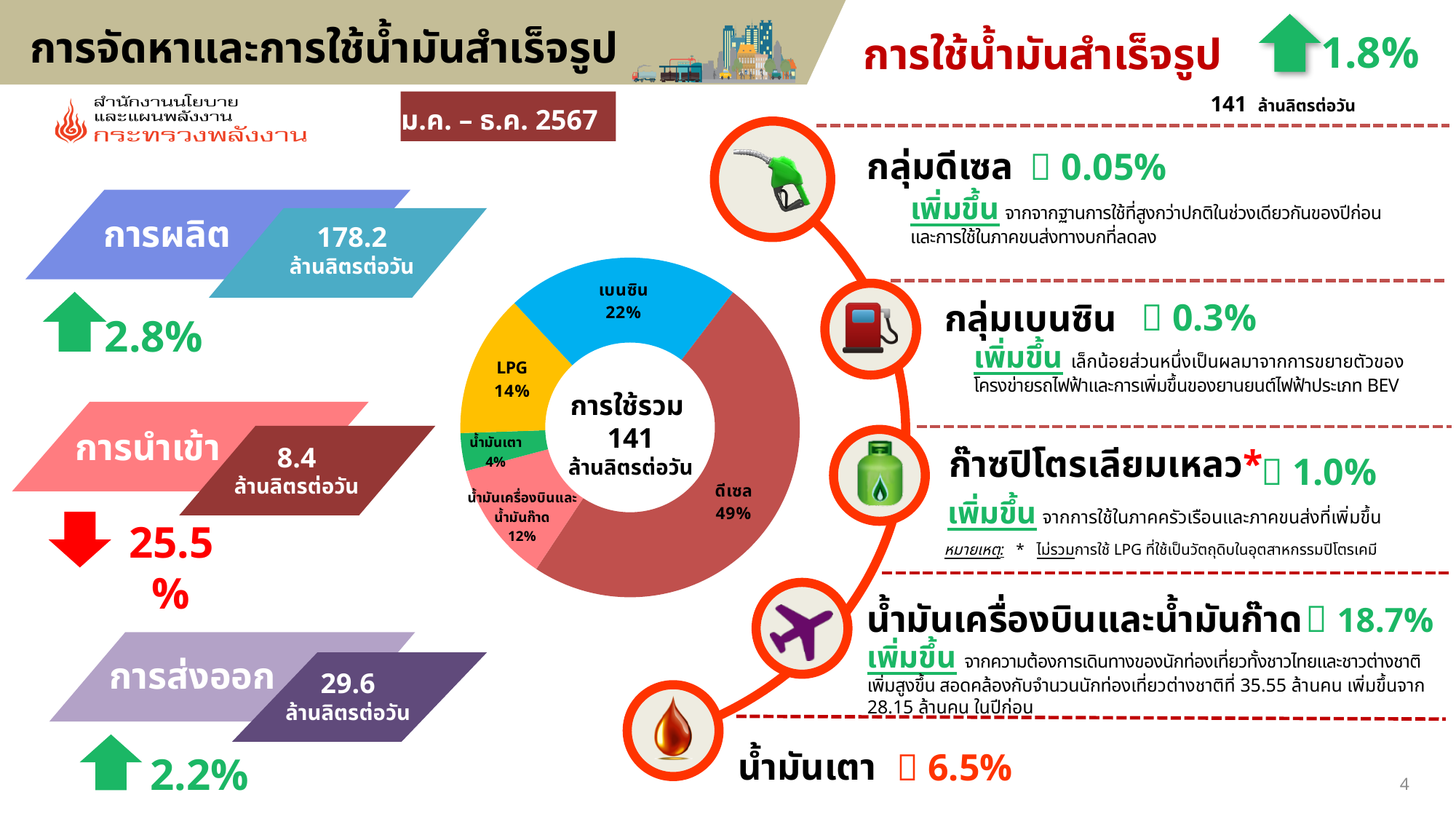
What share of the donut chart does น้ำมันเตา account for? 4% What share of the donut chart does ดีเซล account for? 49% In the donut chart, which has a larger share, LPG or น้ำมันเครื่องบินและน้ำมันก๊าด? LPG What share of the donut chart does เบนซิน account for? 22% What kind of chart is shown in the middle of the slide? Donut (pie) chart In the donut chart, what is the difference in share between ดีเซล and เบนซิน? 27% What total value is shown in the centre of the donut chart? 141 ล้านลิตรต่อวัน What share of the donut chart does LPG account for? 14% Which category has the smallest share in the donut chart? น้ำมันเตา How many categories are shown in the donut chart? 5 Which category has the largest share in the donut chart? ดีเซล What share of the donut chart does น้ำมันเครื่องบินและน้ำมันก๊าด account for? 12%